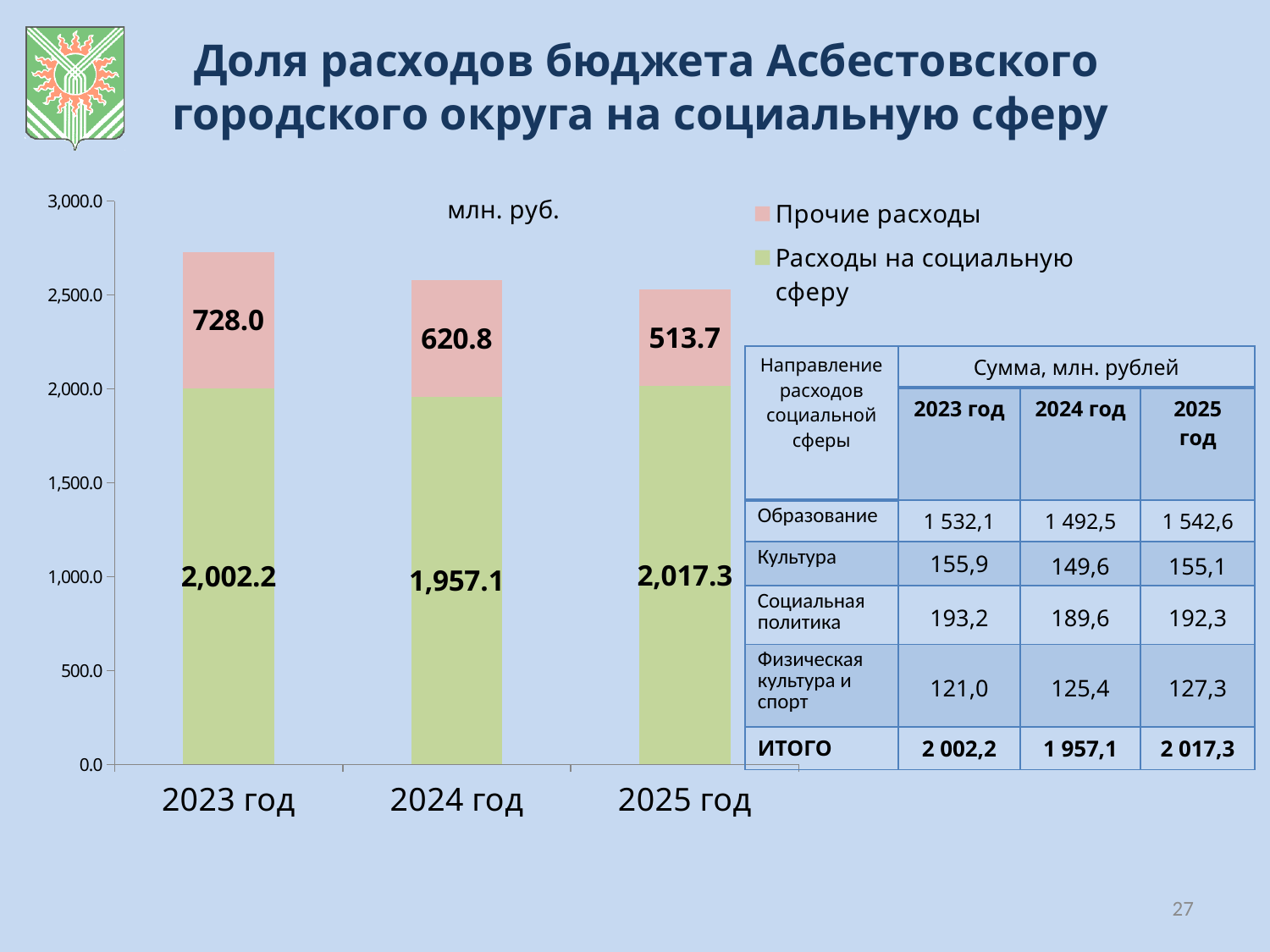
How many series does the chart legend list? 2 What is the value for Расходы на социальную сферу in 2023 год? 2,002.2 Do the values for Прочие расходы rise or fall from 2023 год to 2025 год? Fall Which year has the lowest value for Прочие расходы? 2025 год What kind of chart is shown on the slide? Stacked bar chart What is the total of the stacked bar for 2024 год? 2,577.9 What is the value for Прочие расходы in 2024 год? 620.8 Which is larger: Расходы на социальную сферу in 2024 год or in 2025 год? 2025 год What is the difference between Прочие расходы in 2023 год and in 2025 год? 214.3 How many years are shown on the x axis of the chart? 3 Which year has the highest value for Расходы на социальную сферу? 2025 год What is the value for Прочие расходы in 2025 год? 513.7